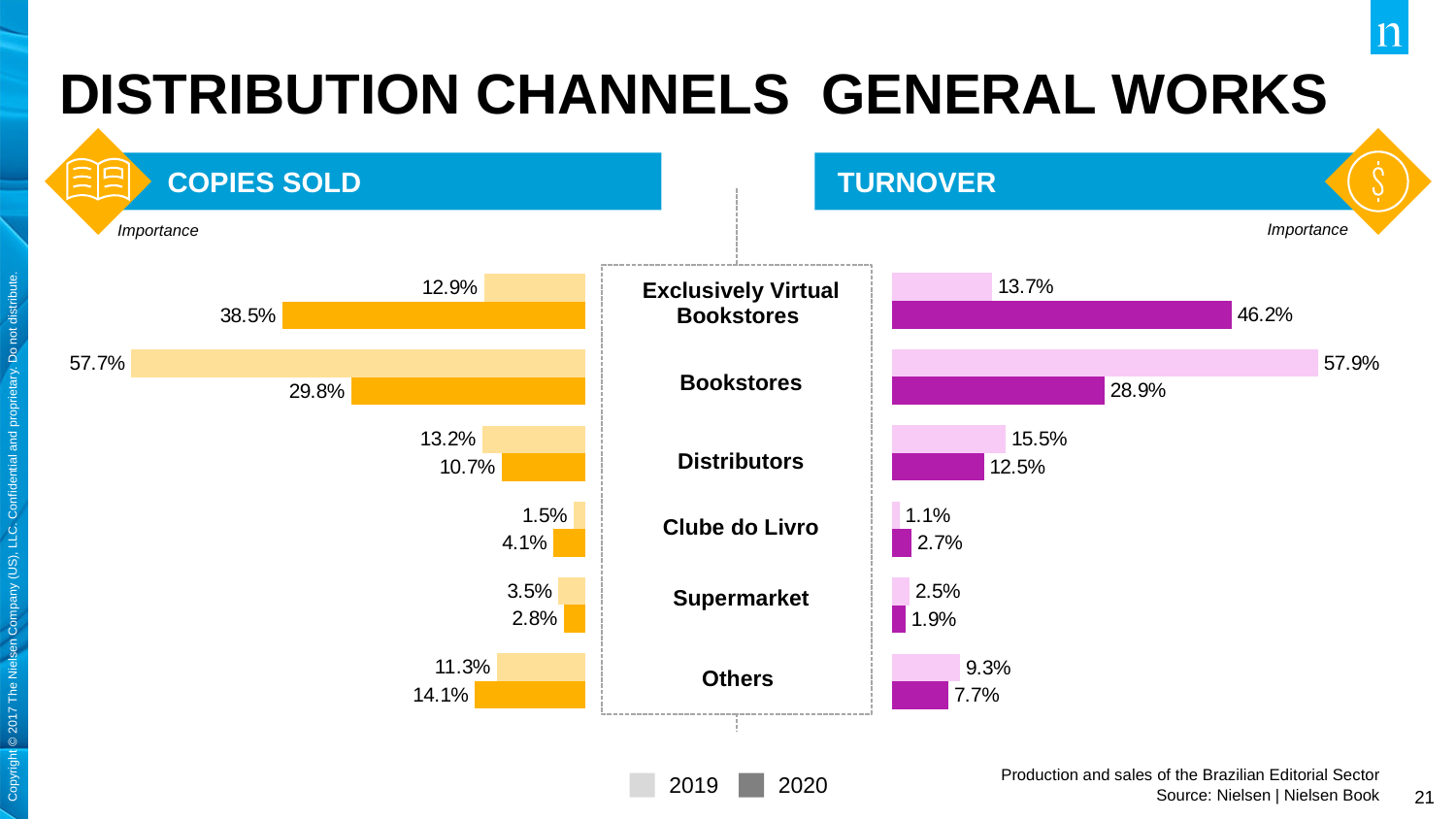
In the TURNOVER chart, what is the difference between the 2020 and 2019 values for Exclusively Virtual Bookstores? 32.5% How many series does the legend list for the charts? 2 In the TURNOVER chart, which category has the highest 2020 value? Exclusively Virtual Bookstores In the COPIES SOLD chart, what is the 2020 value for Exclusively Virtual Bookstores? 38.5% In the COPIES SOLD chart, which category has the lowest 2019 value? Clube do Livro In the COPIES SOLD chart, what is the difference between the 2019 and 2020 values for Bookstores? 27.9% In the COPIES SOLD chart, which is larger for Others: the 2019 value or the 2020 value? 2020 What type of chart is the COPIES SOLD chart? Bar chart How many categories are shown in the TURNOVER chart? 6 In the TURNOVER chart, what is the 2019 value for Bookstores? 57.9% In the TURNOVER chart, is the 2019 value for Distributors larger or smaller than the 2020 value for Distributors? larger In the COPIES SOLD chart, what is the 2019 value for Supermarket? 3.5%